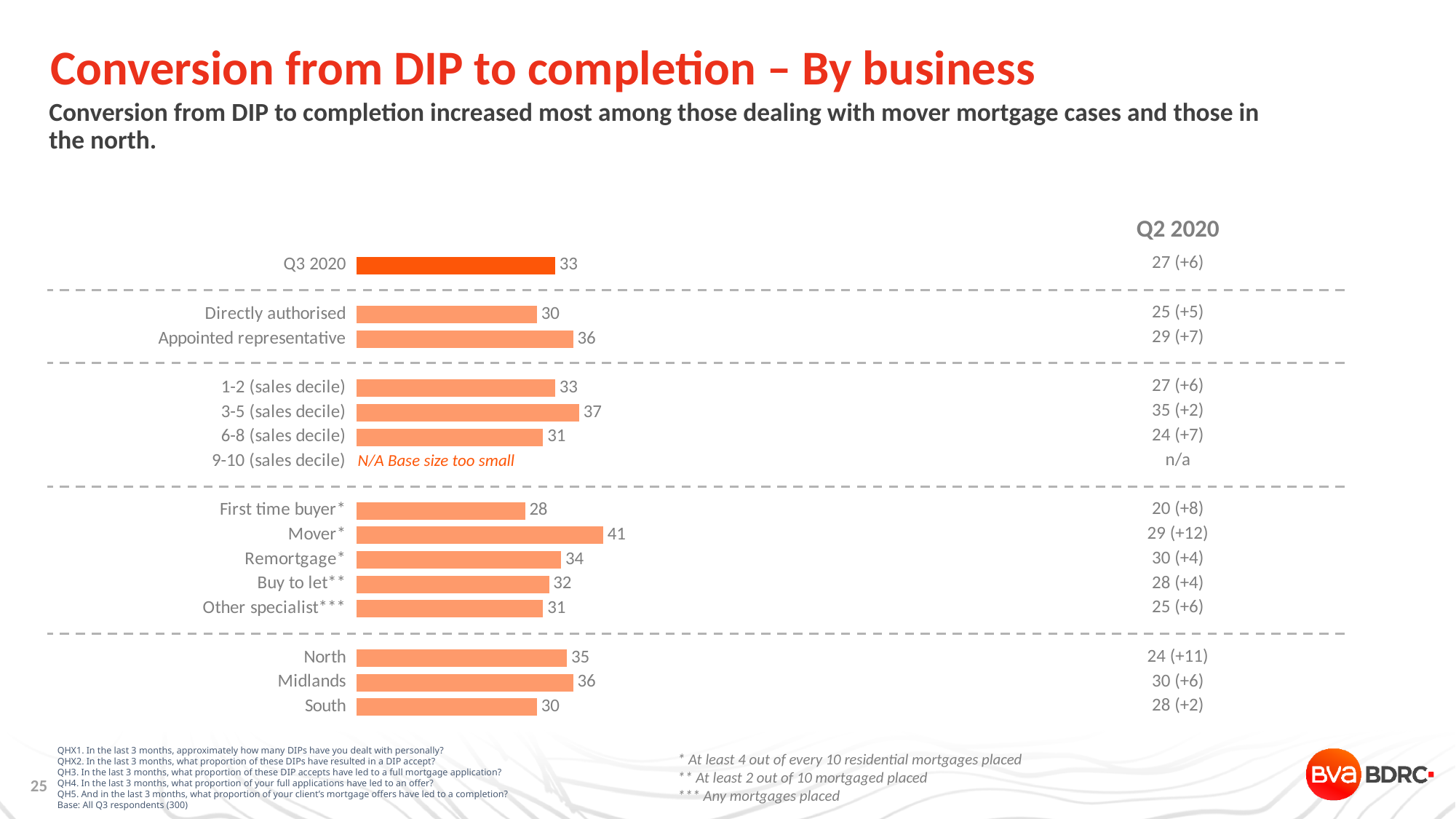
What is the difference between the values for Appointed representative and Directly authorised? 6 What is the Q2 2020 value shown for North? 24 (+11) What is shown for the 9-10 (sales decile) category instead of a bar? N/A Base size too small What kind of chart is shown on the slide? Bar chart What is the value for Appointed representative? 36 Which has a larger value, North or South? North What is the difference between the values for Mover and First time buyer? 13 What is the value for Mover in the bar chart? 41 Which category has the highest value in the bar chart? Mover What is the value for Q3 2020 overall in the bar chart? 33 Which category has the lowest plotted value in the bar chart? First time buyer How many region categories (North, Midlands, South) are plotted in the bottom group? 3